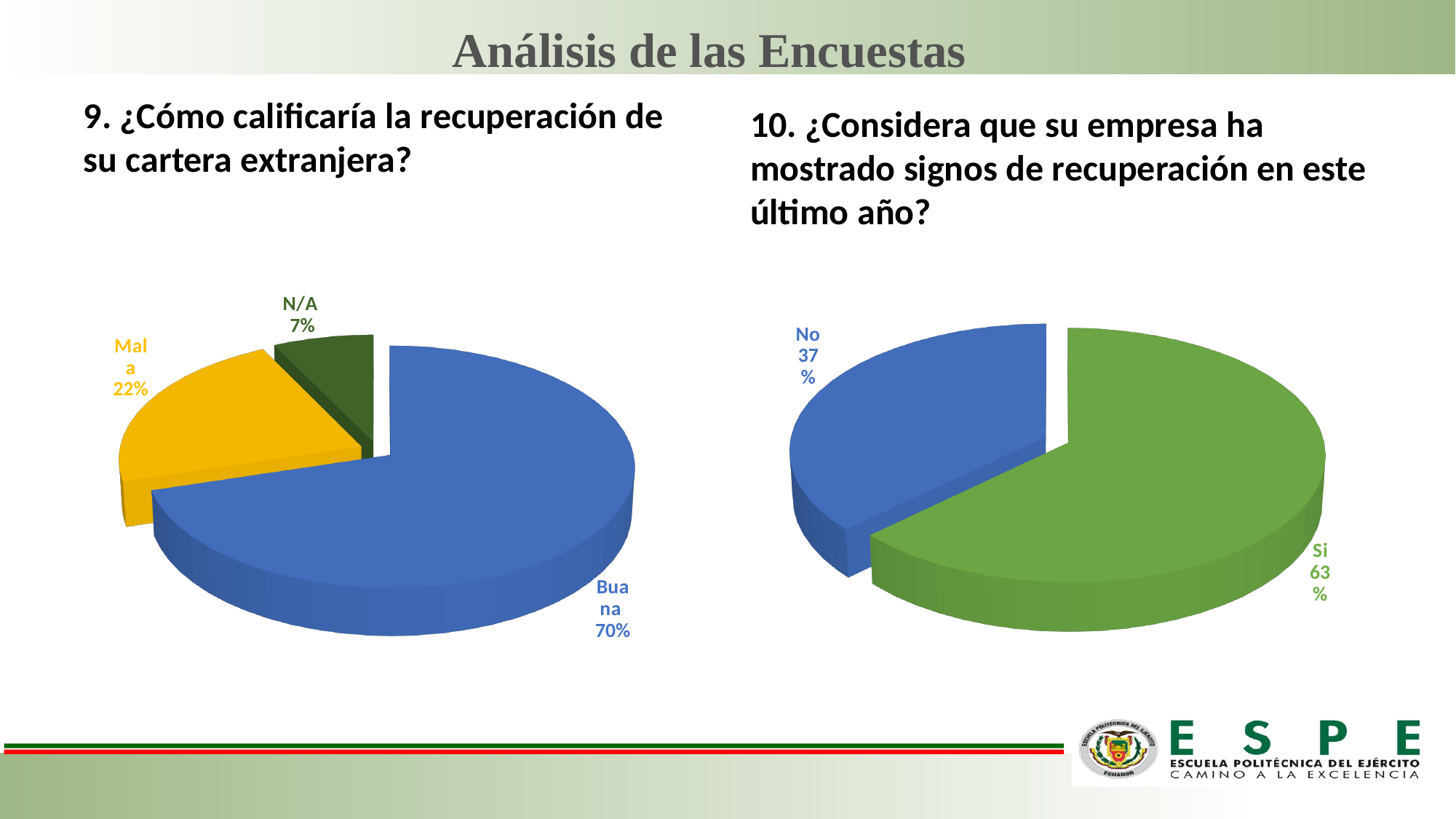
In the left pie chart (question 9), what is the difference in percentage points between 'Buana' and 'Mala'? 48 In the left pie chart (question 9), what percentage is labelled 'N/A'? 7% In the left pie chart (question 9), which category has the largest share? Buana In the left pie chart (question 9), how many slices are there? 3 What type of chart is used for question 10 on the right? Pie chart In the right pie chart (question 10), what percentage answered 'Si'? 63% In the left pie chart (question 9), what percentage is labelled 'Buana'? 70% In the left pie chart (question 9), what percentage is labelled 'Mala'? 22% In the right pie chart (question 10), which is larger, 'Si' or 'No'? Si In the right pie chart (question 10), what percentage answered 'No'? 37% In the right pie chart (question 10), what is the difference in percentage points between 'Si' and 'No'? 26 In the left pie chart (question 9), which category has the smallest share? N/A